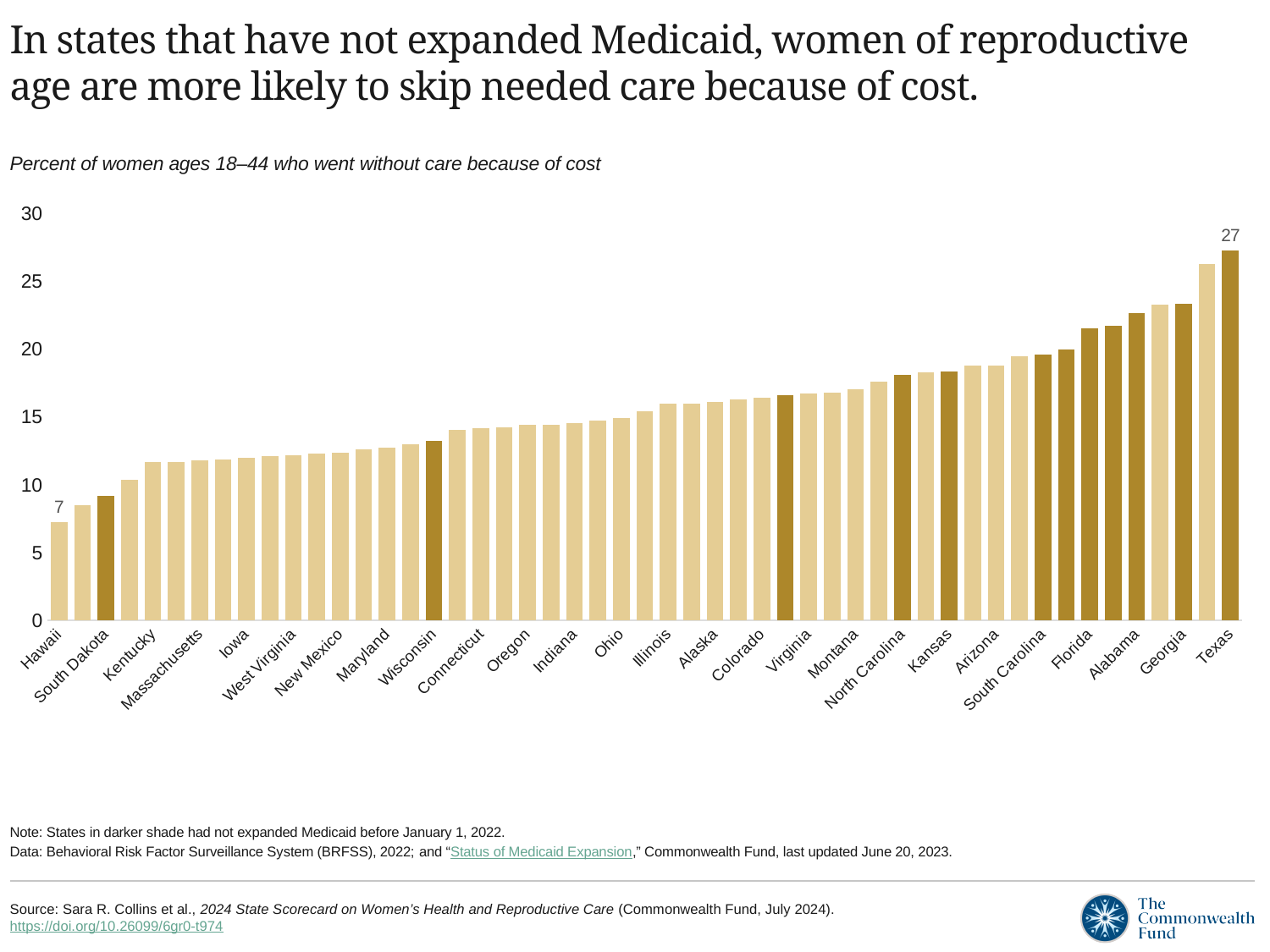
According to the note, what do the darker-shaded bars represent? States that had not expanded Medicaid before January 1, 2022 Is the value for Wisconsin greater or less than 15? less Which state has the lowest percent of women who went without care because of cost? Hawaii Do the values rise or fall moving from left to right along the x axis? Rise What is the value for Hawaii? 7 Which is larger, the value for Texas or the value for Hawaii? Texas What kind of chart is shown on the slide? Bar chart Which state has the highest percent of women who went without care because of cost? Texas Is the value for Kentucky greater or less than 10? greater What is the value for Texas? 27 Is the value for Florida greater or less than 20? greater What is the difference between the values for Texas and Hawaii? 20